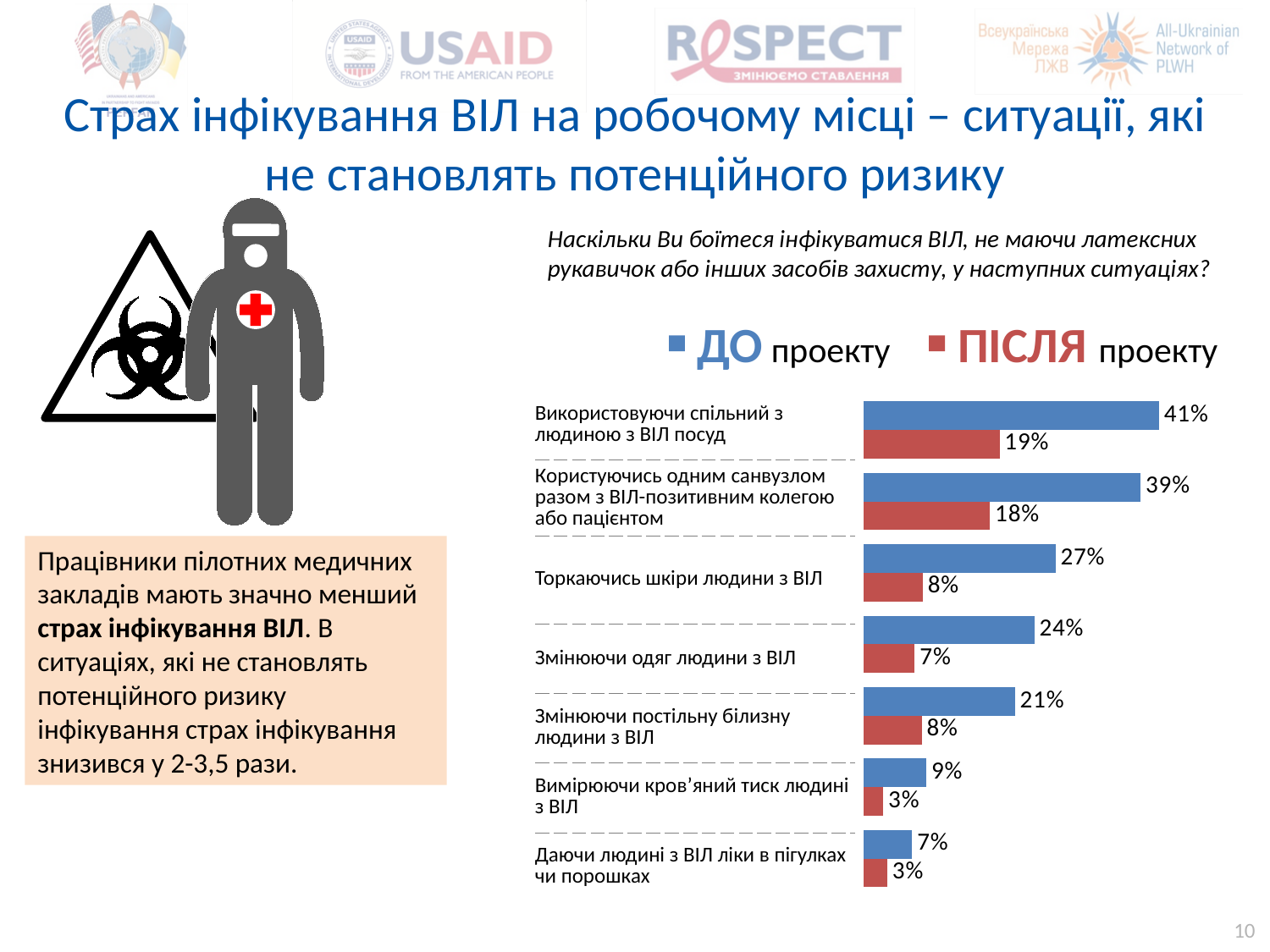
What type of chart is shown on the slide? bar chart Which colour represents the 'ПІСЛЯ проекту' series in the chart? red Which is larger: the 'ДО проекту' value for 'Змінюючи одяг людини з ВІЛ' or the 'ДО проекту' value for 'Змінюючи постільну білизну людини з ВІЛ'? Змінюючи одяг людини з ВІЛ How many series does the chart legend list? 2 How many categories (situations) are shown in the chart? 7 What is the 'ПІСЛЯ проекту' value for 'Торкаючись шкіри людини з ВІЛ'? 8% Which category has the lowest 'ДО проекту' value? Даючи людині з ВІЛ ліки в пігулках чи порошках Which category has the highest 'ПІСЛЯ проекту' value? Використовуючи спільний з людиною з ВІЛ посуд What is the 'ДО проекту' value for 'Вимірюючи кров’яний тиск людині з ВІЛ'? 9% What is the difference between the 'ДО проекту' and 'ПІСЛЯ проекту' values for 'Користуючись одним санвузлом разом з ВІЛ-позитивним колегою або пацієнтом'? 21% Which category has the highest 'ДО проекту' value? Використовуючи спільний з людиною з ВІЛ посуд What is the 'ДО проекту' value for 'Використовуючи спільний з людиною з ВІЛ посуд'? 41%